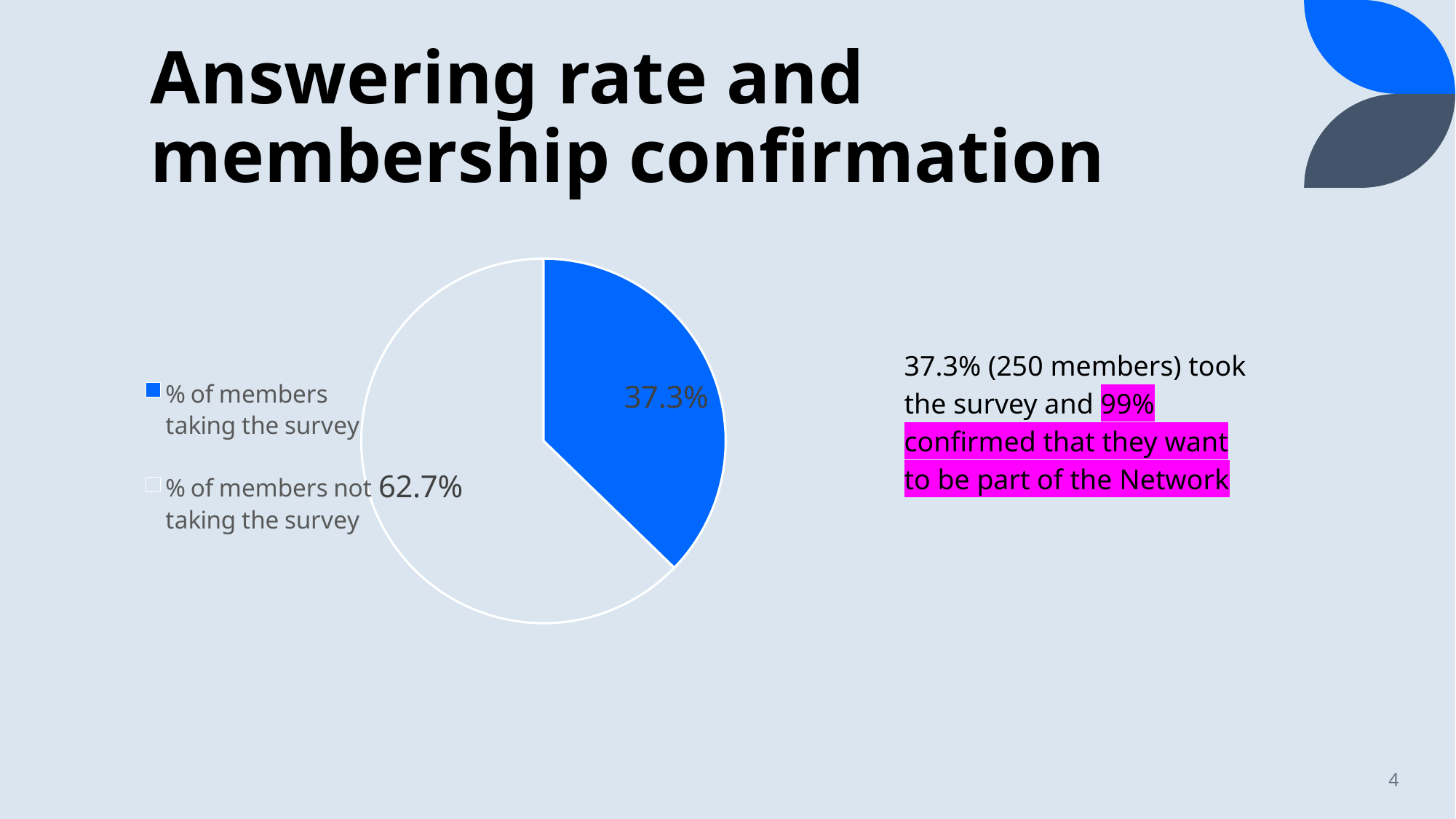
What is the title of the slide containing the pie chart? Answering rate and membership confirmation Which category has the smallest slice in the pie chart? % of members taking the survey What is the difference in percentage points between the share of members not taking the survey and the share taking the survey? 25.4 Which slice of the pie chart is larger: members taking the survey or members not taking the survey? % of members not taking the survey What percentage of members did not take the survey according to the pie chart? 62.7% Is the share of members taking the survey greater or less than 50%? less What kind of chart is shown on the slide? pie chart What colour is the slice representing members taking the survey? blue What percentage of members took the survey according to the pie chart? 37.3% Which category has the largest slice in the pie chart? % of members not taking the survey How many entries does the legend of the pie chart list? 2 How many slices does the pie chart have? 2